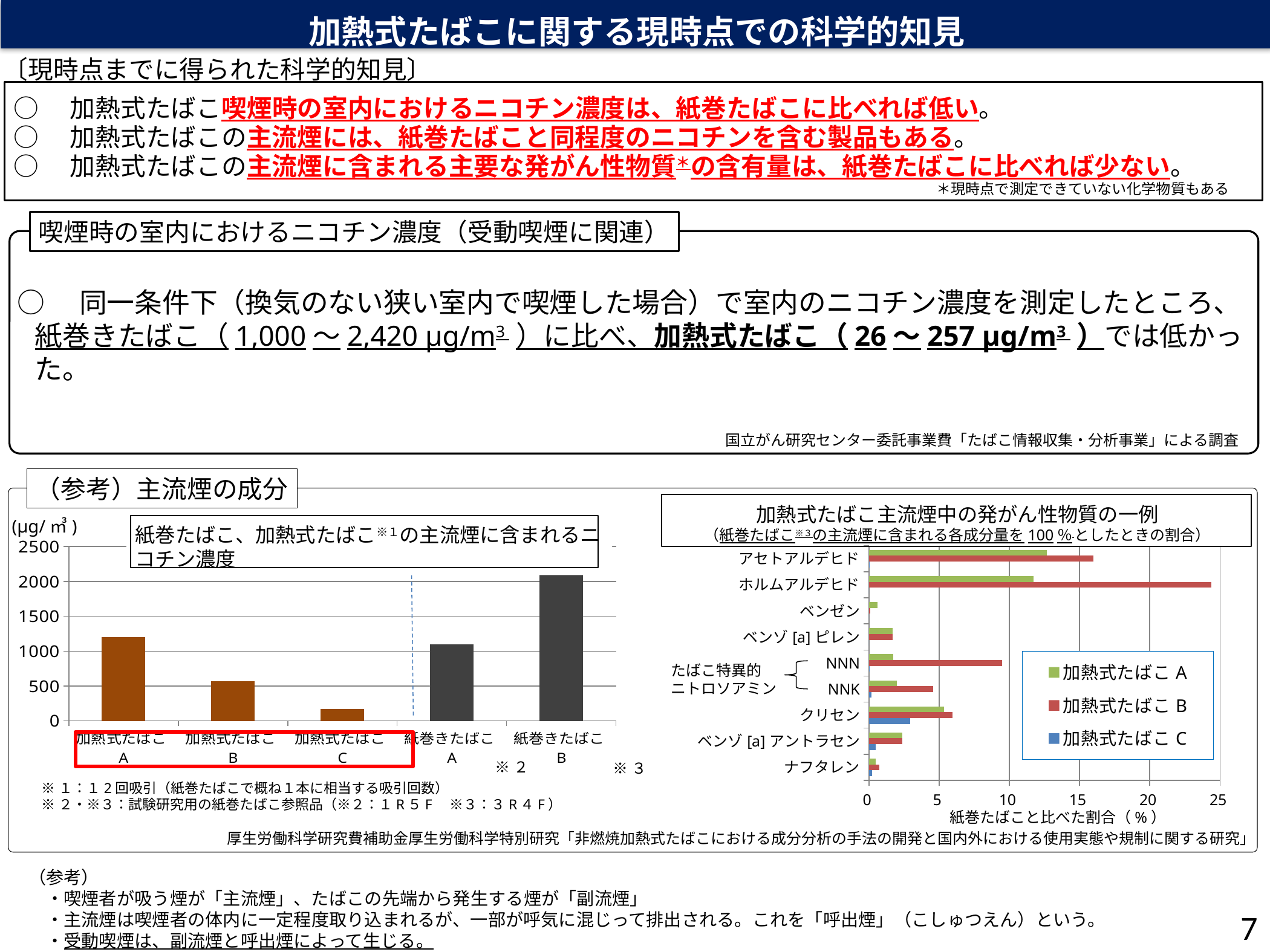
In the left chart (ニコチン濃度), is the value for 紙巻きたばこ B greater or less than 2000? greater In the right chart (加熱式たばこ主流煙中の発がん性物質の一例), is the value of 加熱式たばこ B for ホルムアルデヒド greater or less than 20? greater In the left chart (ニコチン濃度), which category has the lowest value? 加熱式たばこ C In the left chart (ニコチン濃度), which is larger, the value for 加熱式たばこ A or 加熱式たばこ B? 加熱式たばこ A In the right chart (加熱式たばこ主流煙中の発がん性物質の一例), how many series does the legend list? 3 In the right chart (加熱式たばこ主流煙中の発がん性物質の一例), for which substance does 加熱式たばこ B have its highest value? ホルムアルデヒド In the right chart (加熱式たばこ主流煙中の発がん性物質の一例), how many substances are listed on the vertical axis? 9 In the left chart (ニコチン濃度), is the value for 加熱式たばこ C greater or less than 500? less In the left chart (ニコチン濃度), which category has the highest value? 紙巻きたばこ B In the left chart (ニコチン濃度), how many categories are plotted on the x axis? 5 What kind of chart is the left chart showing nicotine concentration in mainstream smoke (紙巻たばこ、加熱式たばこの主流煙に含まれるニコチン濃度)? bar chart